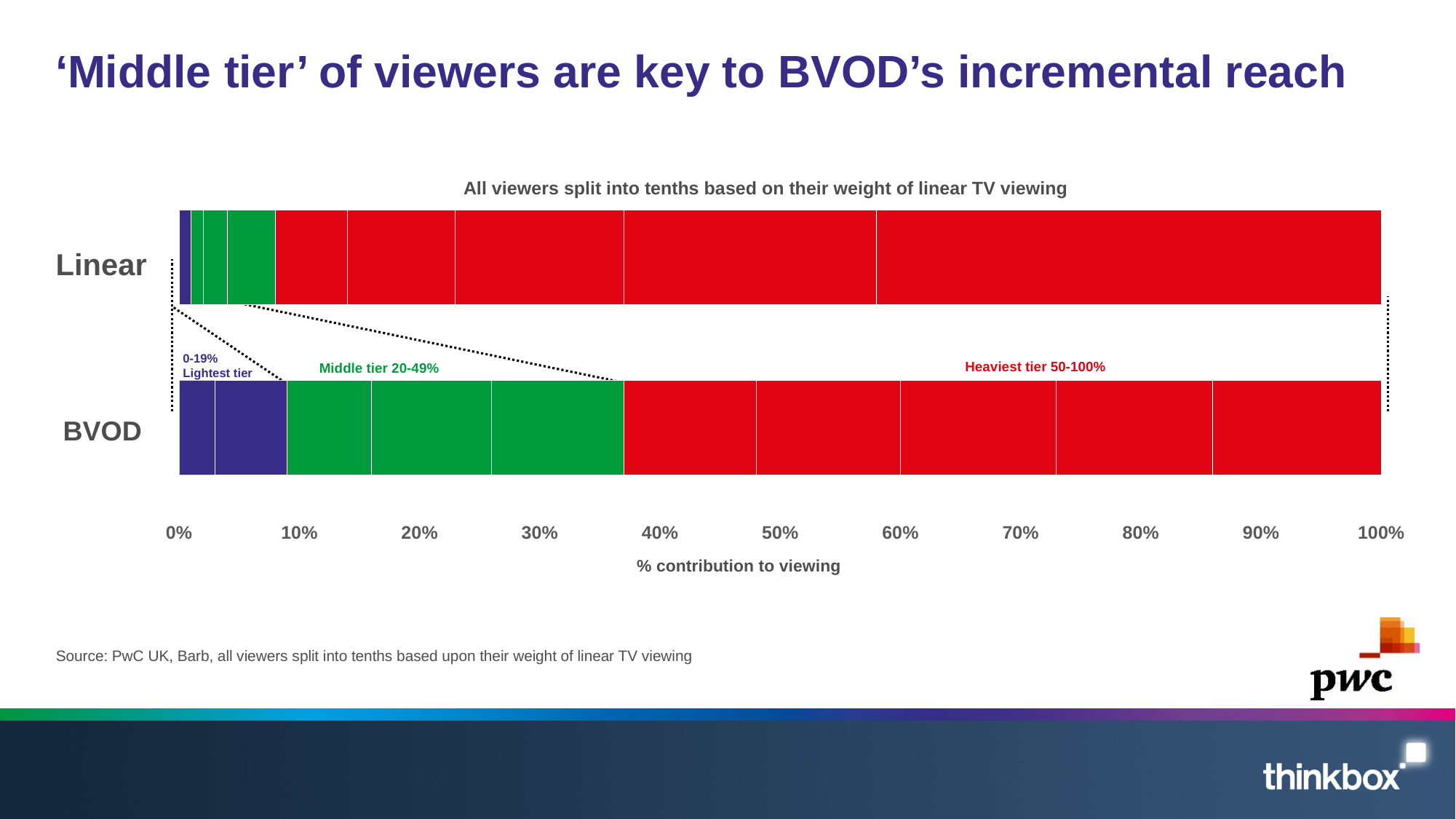
Is the combined contribution of the lightest and middle tiers for Linear greater or less than 10%? less Which category has the larger heaviest tier (red) contribution to viewing, Linear or BVOD? Linear How many categories (bars) does the chart show? 2 Is the combined contribution of the lightest and middle tiers for BVOD greater or less than 40%? less What are the two categories plotted on the chart? Linear and BVOD What is the highest value shown on the x axis? 100% Which category has the larger middle tier (green) contribution to viewing, Linear or BVOD? BVOD Which tier is shown in green? Middle tier 20-49% Is the heaviest tier's contribution to Linear viewing greater or less than 90%? greater How many viewer tiers are labelled on the chart? 3 What kind of chart is shown on the slide? Stacked bar chart